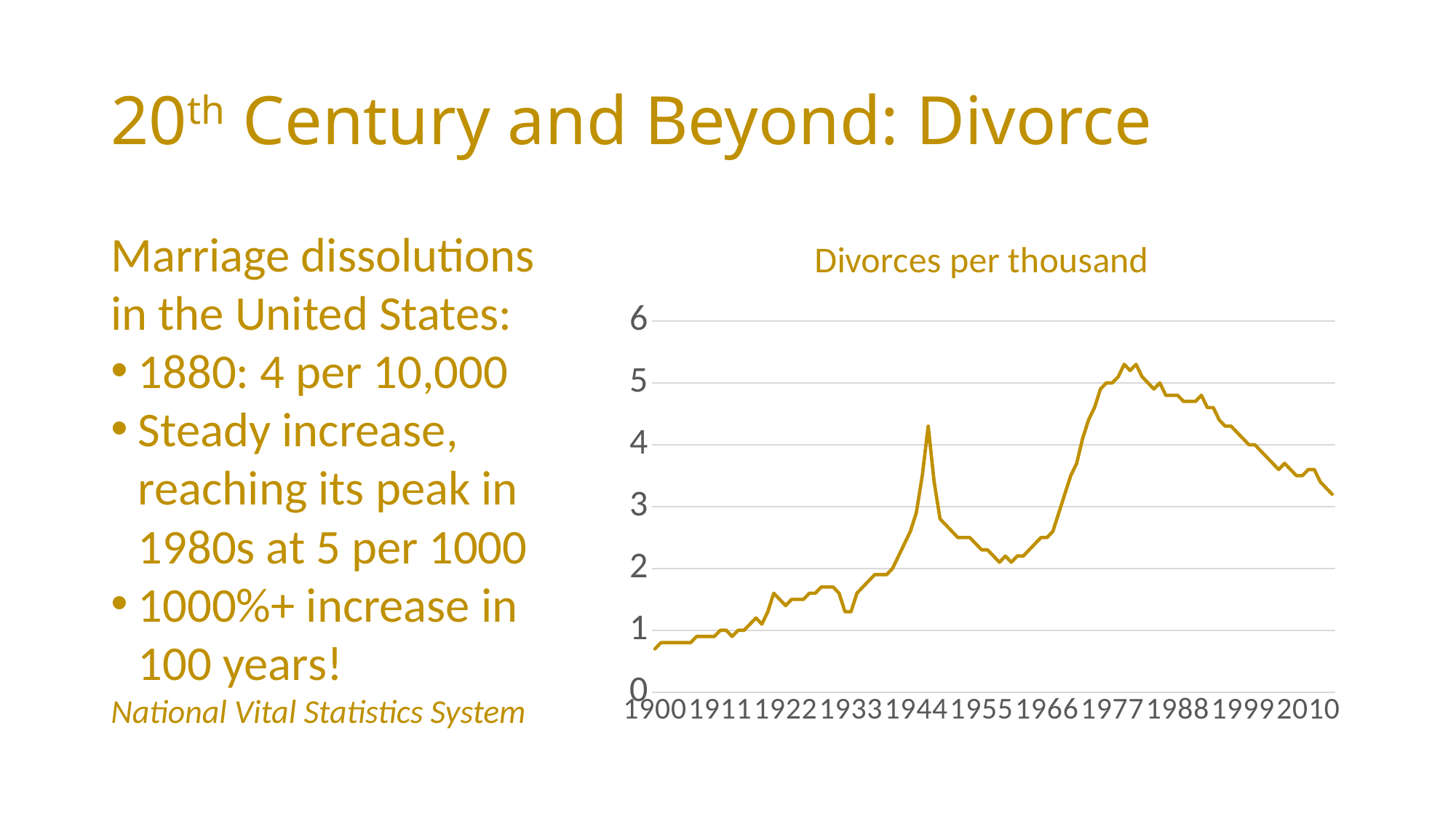
Which is larger, the value for 1966 or the value for 1977? 1977 Do the values rise or fall between 1900 and 1944? rise Is the value for 1944 greater or less than 4? less Is the value for 1900 greater or less than 1? less What is the highest value shown on the y axis? 6 What kind of chart is shown on the slide? line chart Is the value for 1922 greater or less than 1? greater What is the title of the chart? Divorces per thousand Do the values rise or fall between 1988 and 2010? fall